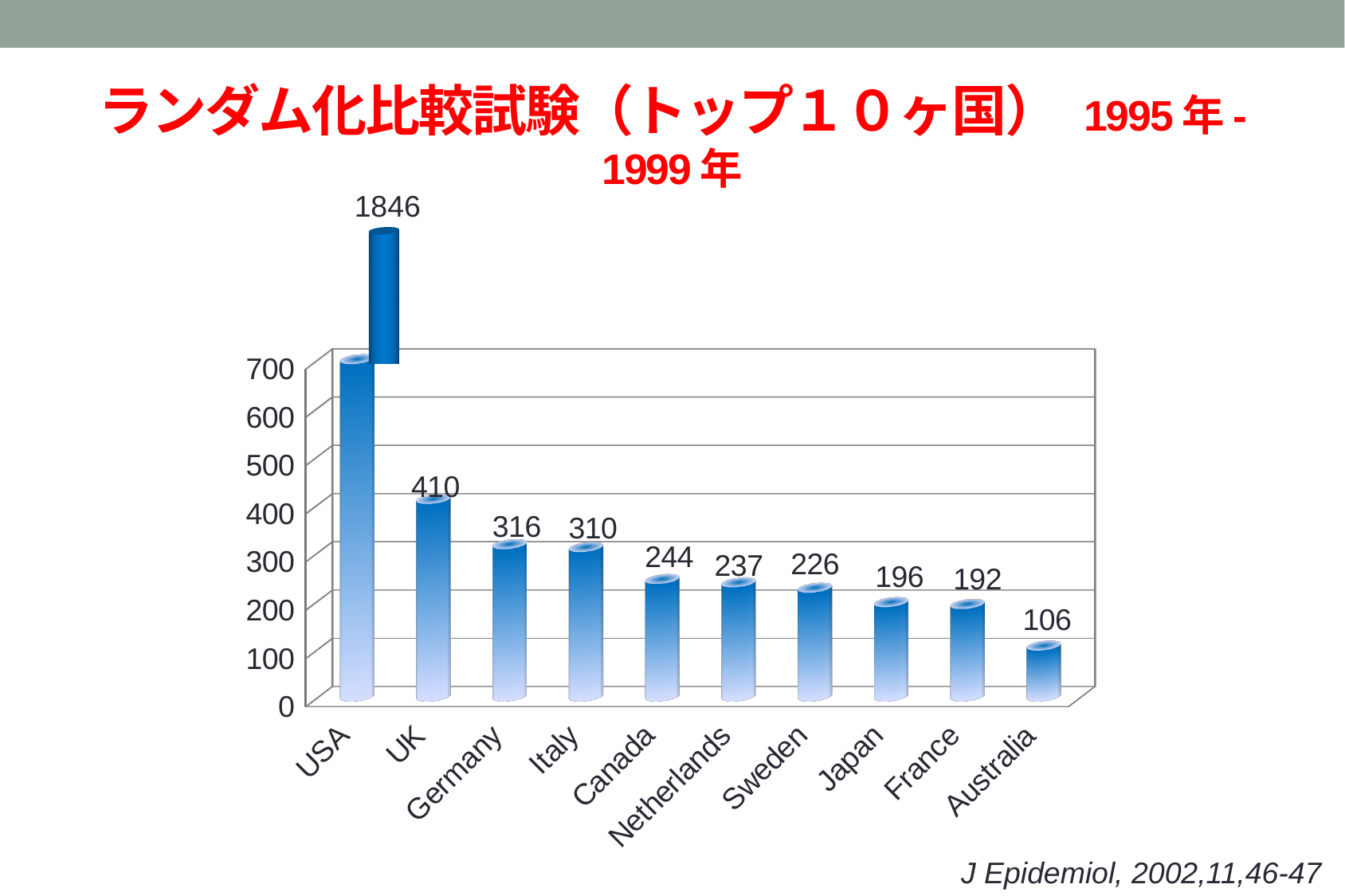
What kind of chart is shown on the slide? Bar chart Which has a larger value, Japan or Germany? Germany What is the difference between the values for the UK and Italy? 100 Which country has the highest value? USA Do the values rise or fall from left to right along the x axis? Fall What is the value for the USA? 1846 What is the difference between the values for Canada and Netherlands? 7 What is the value for Sweden? 226 What source is cited at the bottom of the slide? J Epidemiol, 2002,11,46-47 How many countries are shown in the chart? 10 What is the value for Germany? 316 Which country has the lowest value? Australia